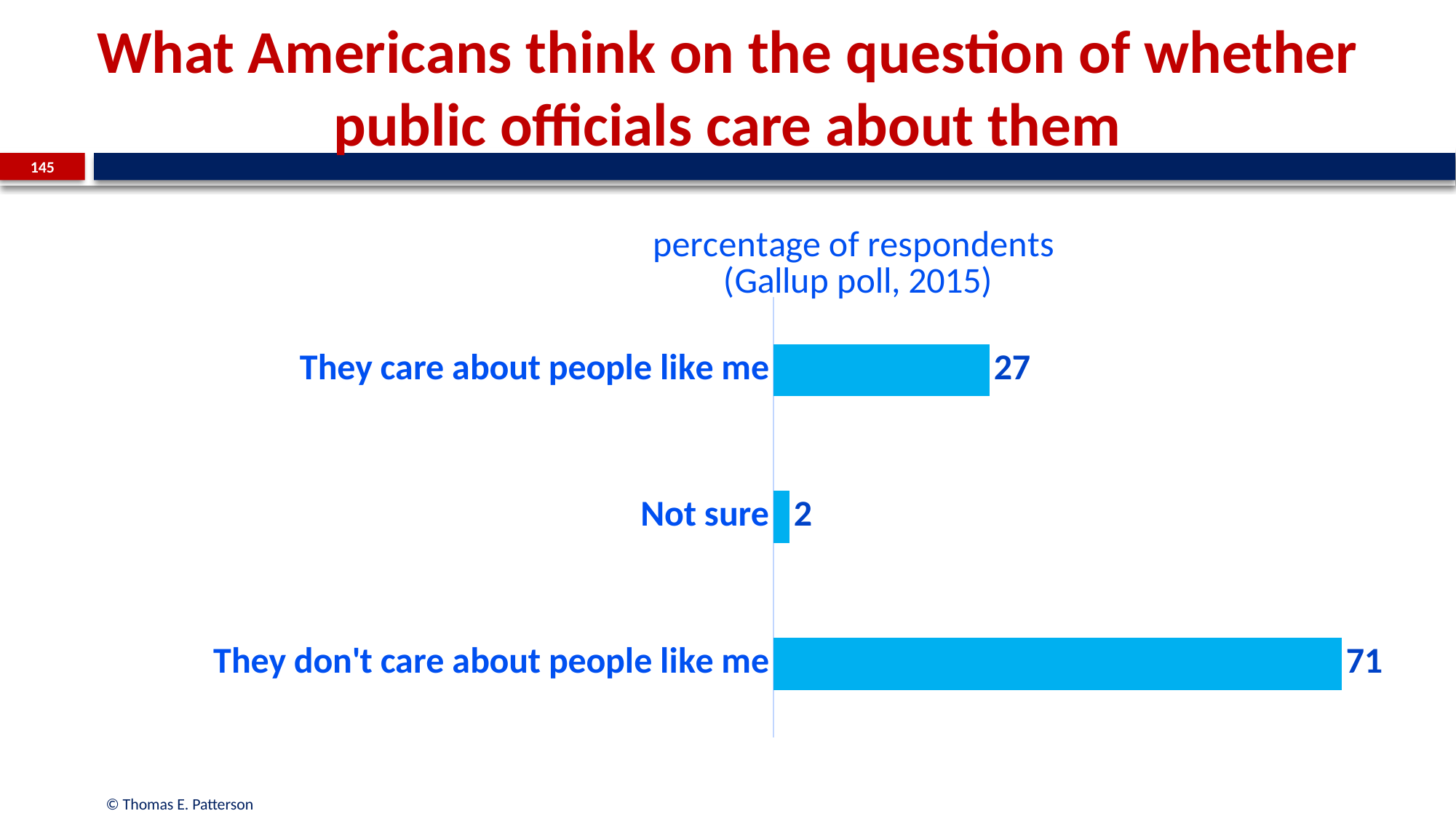
Which is larger: the percentage for "They care about people like me" or for "They don't care about people like me"? They don't care about people like me How many response categories are shown in the chart? 3 What is the title of the chart? percentage of respondents (Gallup poll, 2015) What year is the Gallup poll in the chart title from? 2015 What kind of chart is shown on the slide? Bar chart What percentage of respondents said "Not sure"? 2 Which response has the lowest percentage of respondents? Not sure What is the difference between the percentage for "They don't care about people like me" and "They care about people like me"? 44 What is the difference between the percentage for "They care about people like me" and "Not sure"? 25 What percentage of respondents said "They care about people like me"? 27 What percentage of respondents said "They don't care about people like me"? 71 Which response has the highest percentage of respondents? They don't care about people like me